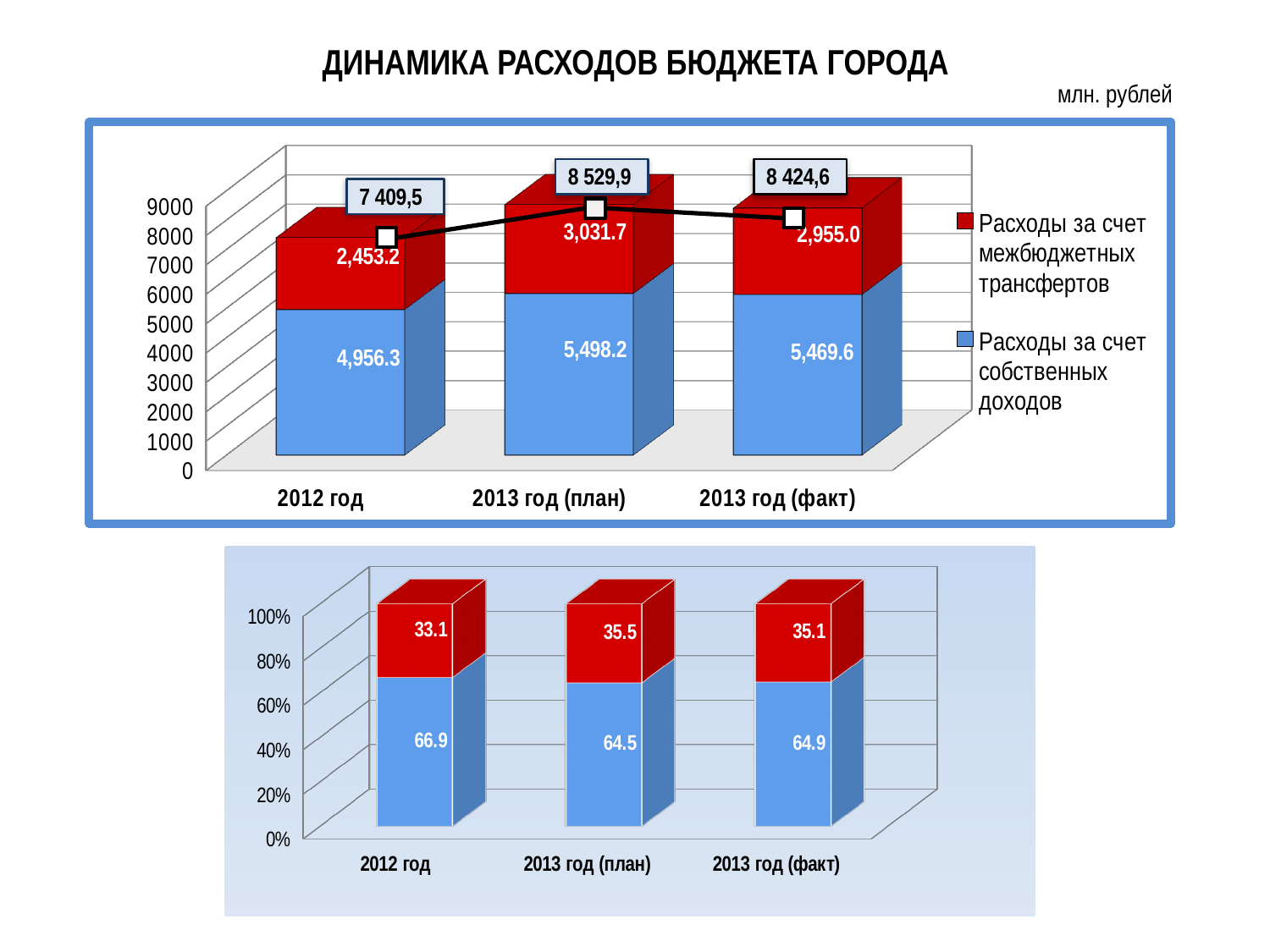
In the top chart, which is larger: 'Расходы за счет межбюджетных трансфертов' for 2013 год (план) or for 2013 год (факт)? 2013 год (план) In the top chart, what total is labelled above the bar for 2013 год (факт)? 8 424,6 What kind of chart is the bottom chart? stacked bar chart How many categories are shown on the x axis of the bottom chart? 3 In the top chart, which category has the lowest value for 'Расходы за счет межбюджетных трансфертов'? 2012 год In the bottom chart, what is the value of the blue segment for 2013 год (план)? 64.5 In the top chart, what is the value of 'Расходы за счет собственных доходов' for 2012 год? 4,956.3 In the top chart, what is the value of 'Расходы за счет межбюджетных трансфертов' for 2013 год (план)? 3,031.7 In the bottom chart, what is the value of the red segment for 2012 год? 33.1 How many series does the legend of the top chart list? 2 In the top chart, which category has the highest total? 2013 год (план) In the top chart, what is the difference between 'Расходы за счет собственных доходов' for 2013 год (план) and 2013 год (факт)? 28.6